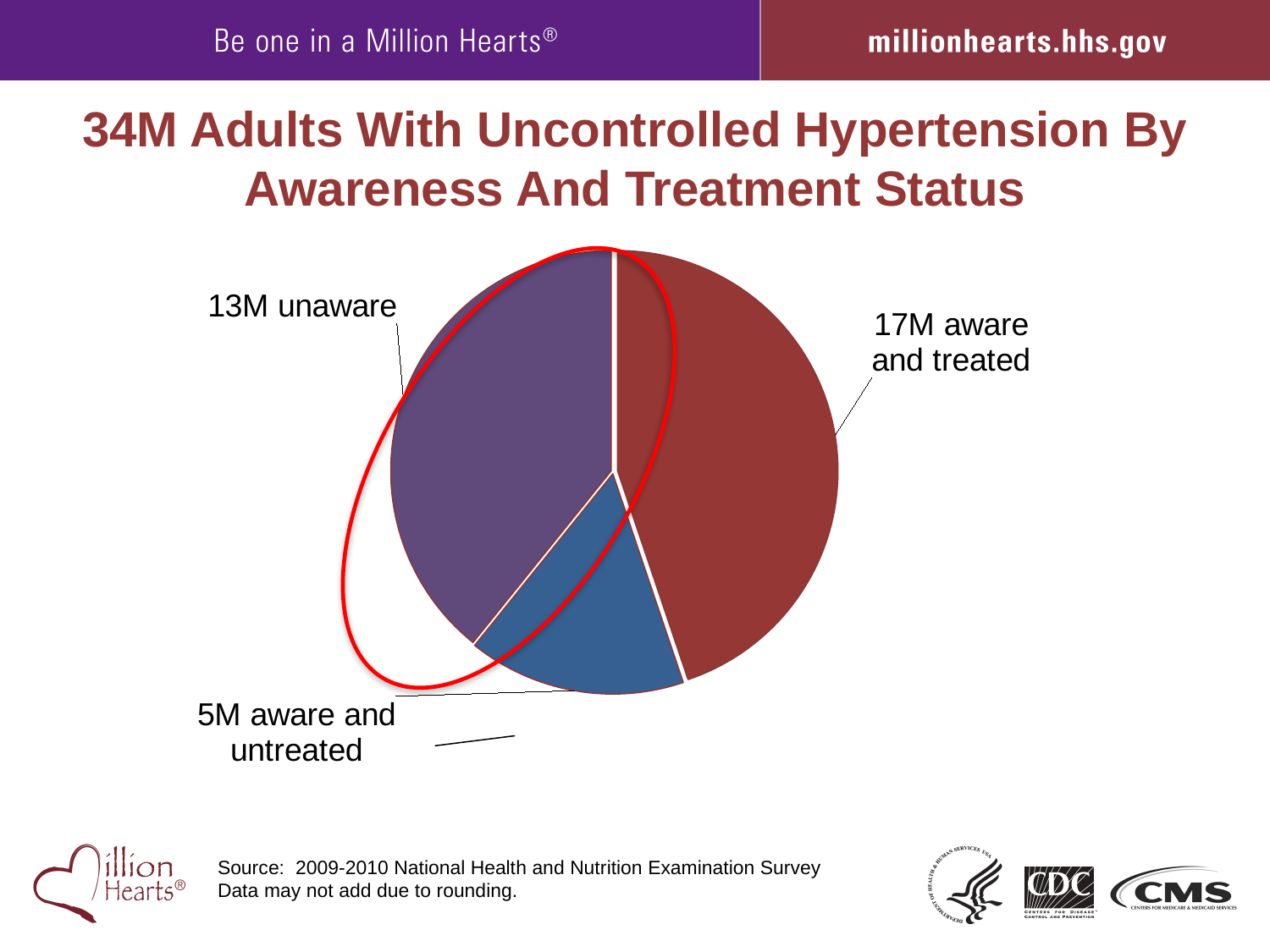
What is the title of the chart on the slide? 34M Adults With Uncontrolled Hypertension By Awareness And Treatment Status What is the difference between the unaware group and the aware and untreated group? 8M Which is larger, the unaware group or the aware and untreated group? Unaware What type of chart is shown on the slide? Pie chart What colour is the slice for the aware and treated group? Red Which slice of the pie chart is the largest? 17M aware and treated Which slice of the pie chart is the smallest? 5M aware and untreated How many adults are labelled as aware and untreated in the pie chart? 5M How many slices does the pie chart have? 3 How many adults are labelled as aware and treated in the pie chart? 17M What is the difference between the aware and treated group and the unaware group? 4M How many adults are labelled as unaware in the pie chart? 13M